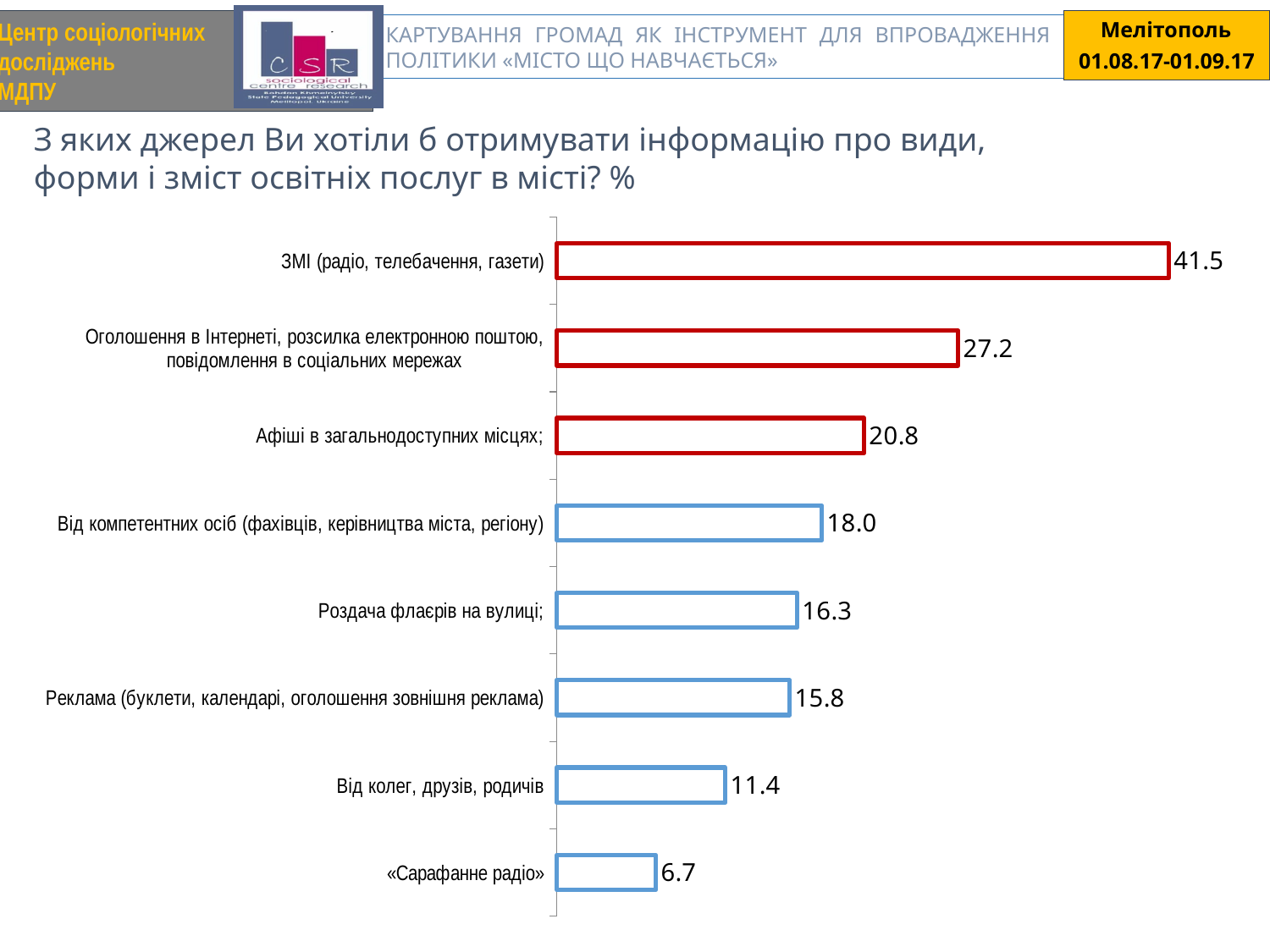
Which category has the highest value? ЗМІ (радіо, телебачення, газети) How many categories (information sources) are plotted in the chart? 8 What is the difference between the values for «ЗМІ (радіо, телебачення, газети)» and «Оголошення в Інтернеті, розсилка електронною поштою, повідомлення в соціальних мережах»? 14.3 What is the value for «Від колег, друзів, родичів»? 11.4 What is the value for «Реклама (буклети, календарі, оголошення зовнішня реклама)»? 15.8 Which category has the lowest value? «Сарафанне радіо» What type of chart is shown on the slide? bar chart What is the difference between the values for «Від компетентних осіб (фахівців, керівництва міста, регіону)» and «Роздача флаєрів на вулиці»? 1.7 How many bars in the chart are outlined in red rather than blue? 3 What is the value for «Афіші в загальнодоступних місцях»? 20.8 What is the value for «ЗМІ (радіо, телебачення, газети)»? 41.5 Which is larger: the value for «Афіші в загальнодоступних місцях» or the value for «Від колег, друзів, родичів»? Афіші в загальнодоступних місцях